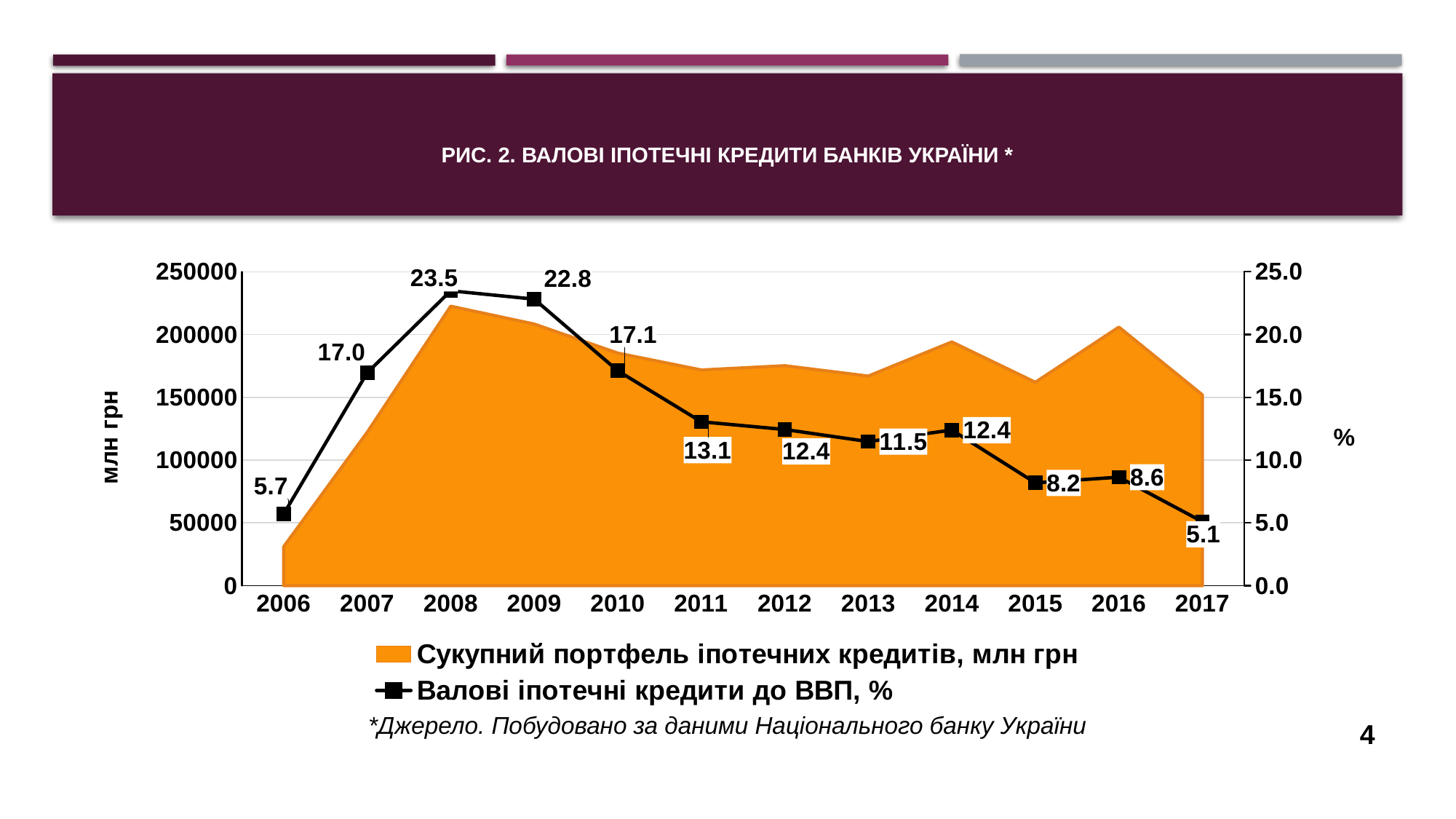
What kind of chart is shown on the slide? A combination of an area chart and a line chart In which year is 'Валові іпотечні кредити до ВВП, %' lowest? 2017 Is the value of 'Сукупний портфель іпотечних кредитів, млн грн' in 2006 greater or less than 50000? less Does 'Валові іпотечні кредити до ВВП, %' rise or fall from 2014 to 2017? fall Is the value of 'Сукупний портфель іпотечних кредитів, млн грн' in 2008 greater or less than 200000? greater In which year is 'Валові іпотечні кредити до ВВП, %' highest? 2008 How many series does the legend list? 2 How many years are shown on the x axis of the chart? 12 Which year has the larger 'Валові іпотечні кредити до ВВП, %' value, 2015 or 2016? 2016 What is the value of 'Валові іпотечні кредити до ВВП, %' in 2008? 23.5 What is the difference between the 'Валові іпотечні кредити до ВВП, %' values for 2008 and 2009? 0.7 What is the value of 'Валові іпотечні кредити до ВВП, %' in 2017? 5.1